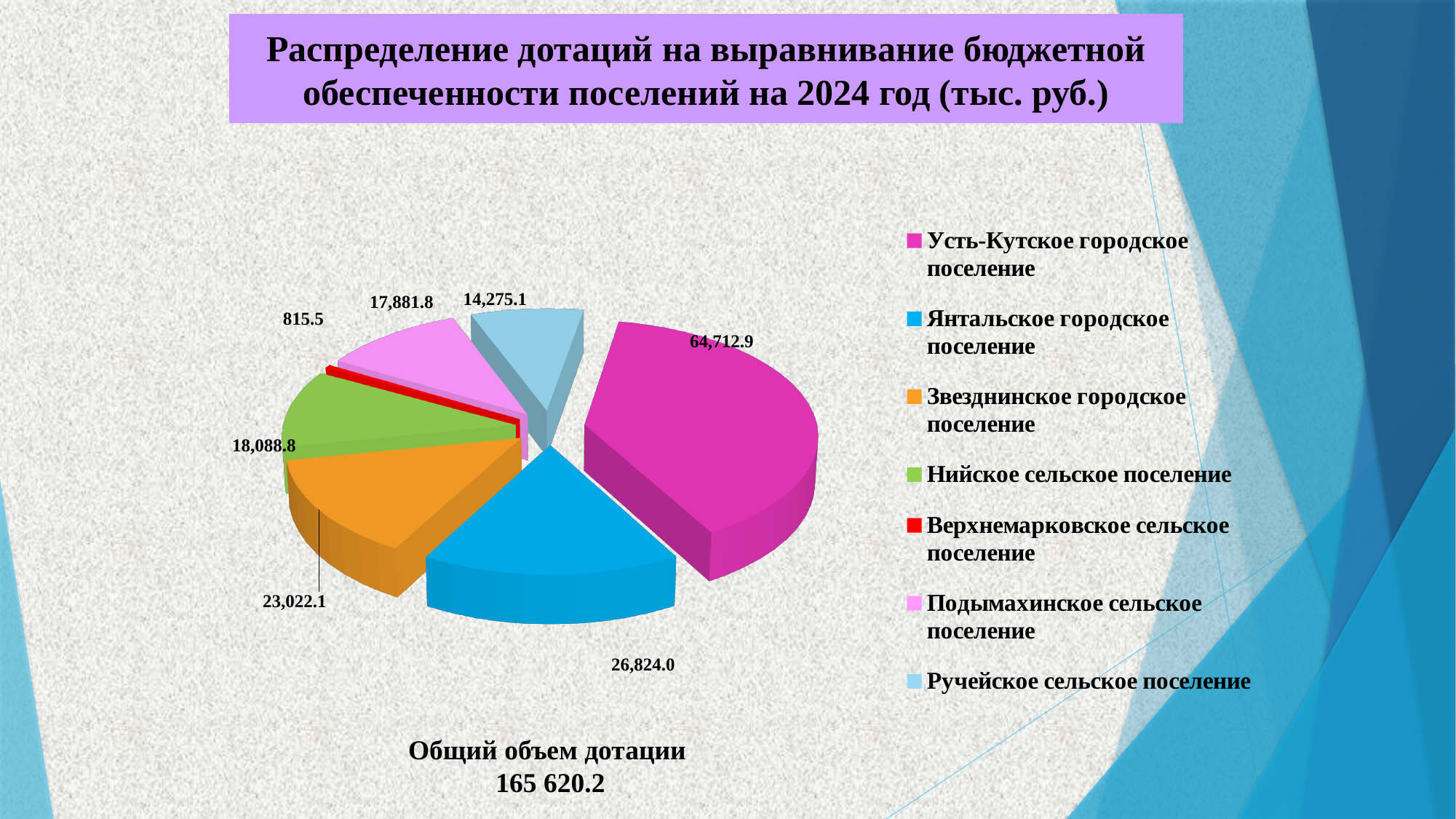
What is the difference between the values for Звезднинское городское поселение and Нийское сельское поселение? 4,933.3 What is the value for Янтальское городское поселение? 26,824.0 Which settlement receives the largest share of the subsidy? Усть-Кутское городское поселение What is the difference between the values for Усть-Кутское городское поселение and Янтальское городское поселение? 37,888.9 Which is larger: the value for Подымахинское сельское поселение or Ручейское сельское поселение? Подымахинское сельское поселение What type of chart is shown on the slide? Pie chart What is the value for Усть-Кутское городское поселение? 64,712.9 Which settlement receives the smallest share of the subsidy? Верхнемарковское сельское поселение What is the value for Верхнемарковское сельское поселение? 815.5 How many settlements (slices) are shown in the pie chart? 7 What is the value for Ручейское сельское поселение? 14,275.1 What total subsidy volume is stated below the chart? 165 620.2